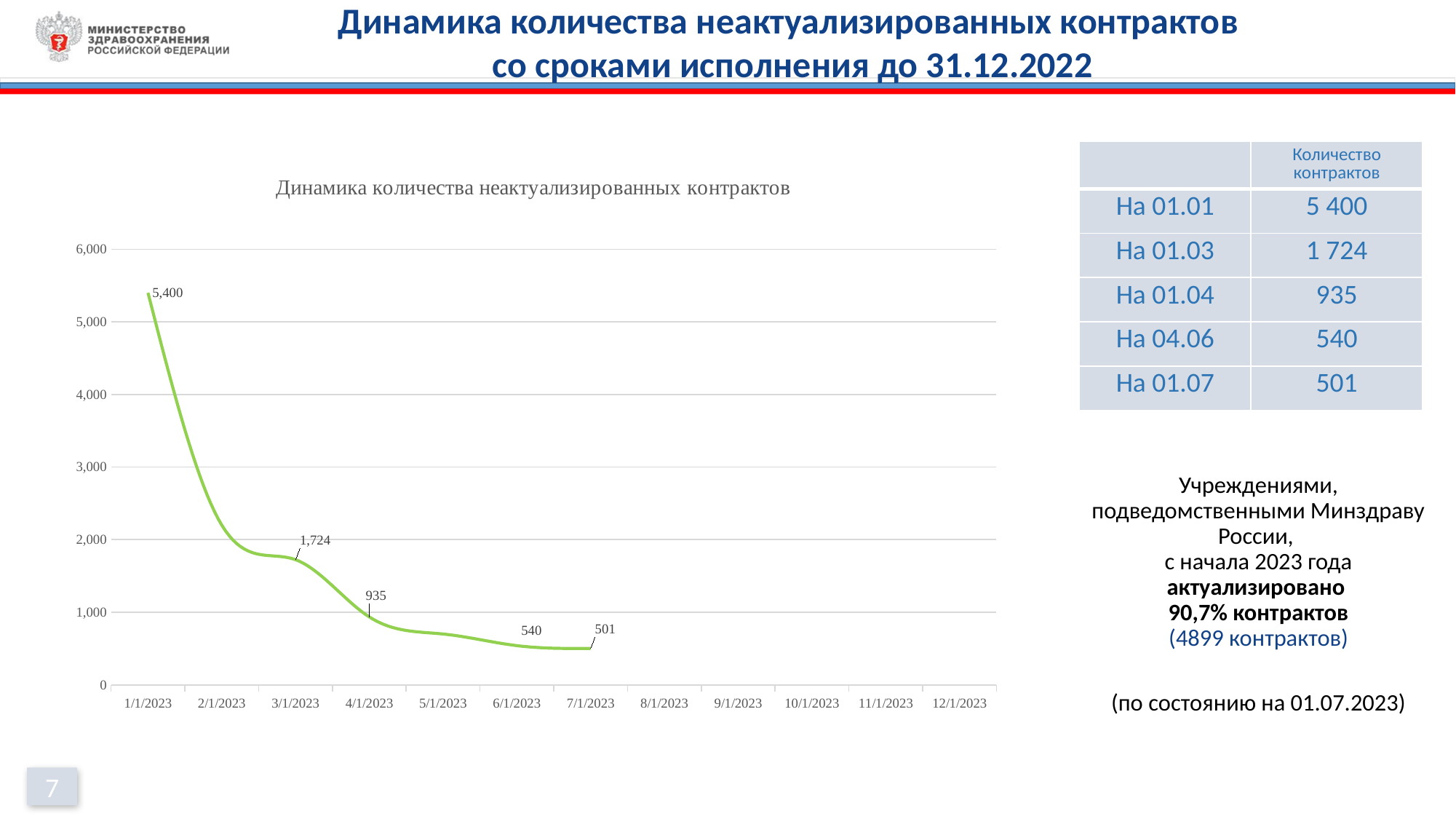
What is the difference between the labelled values 540 and 501? 39 What is the title of the chart? Динамика количества неактуализированных контрактов What is the value labelled at 4/1/2023? 935 What is the difference between the value at 1/1/2023 and the value at 3/1/2023? 3,676 What type of chart is shown on the slide? line chart Does the line rise or fall from 1/1/2023 to 7/1/2023? falls Which labelled data point has the highest value? 1/1/2023 (5,400) What is the value of the first data point, at 1/1/2023? 5,400 What is the value labelled at 3/1/2023? 1,724 What is the value of the last labelled data point, at 7/1/2023? 501 Which labelled data point has the lowest value? 7/1/2023 (501) How many data labels are printed on the line? 5